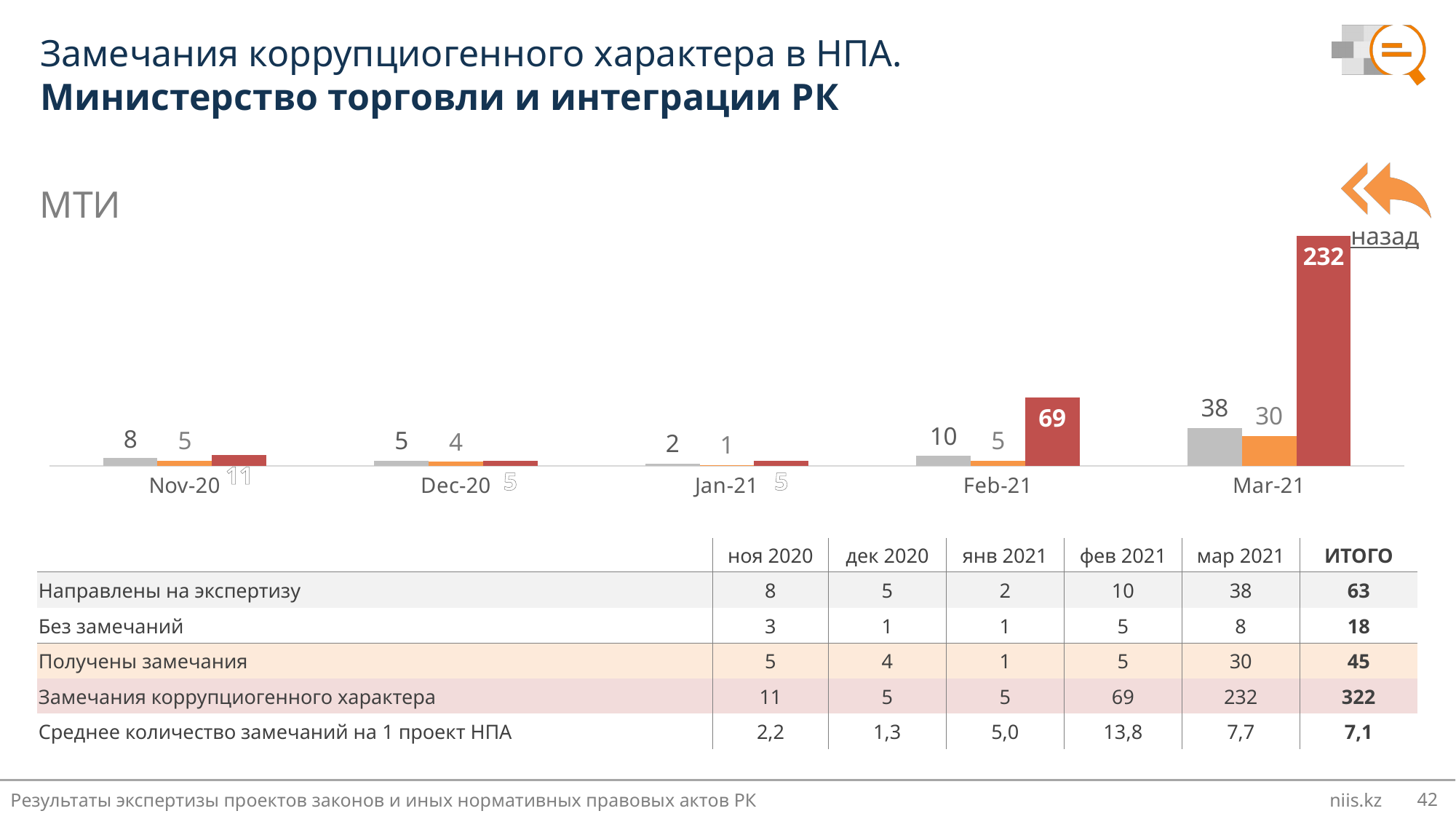
In which month is the red bar the highest? Mar-21 What is the difference between the red bar values for Mar-21 and Feb-21? 163 What is the label shown above the chart on the left? МТИ What is the value of the orange bar for Dec-20? 4 In which month is the grey bar the lowest? Jan-21 What is the value of the red bar for Mar-21? 232 What type of chart is shown on the slide? bar chart How many months (categories) are shown on the x axis of the chart? 5 Which is larger for Mar-21: the grey bar or the orange bar? the grey bar (38) What is the difference between the grey bar and the orange bar for Nov-20? 3 What is the value of the grey bar for Feb-21? 10 What is the value of the red bar for Feb-21? 69